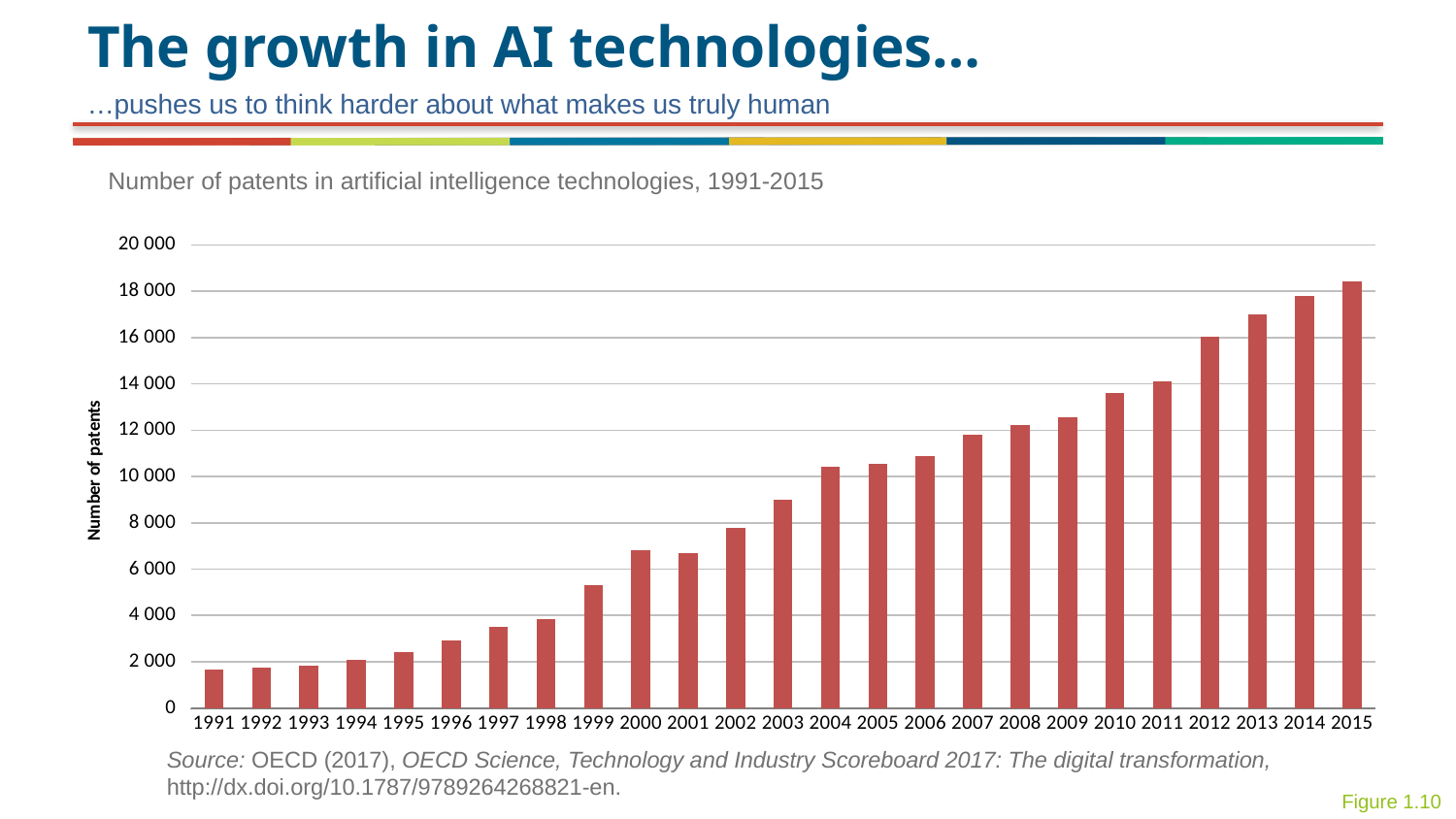
Is the value for 2003 greater or less than 10 000? less Is the value for 1999 greater or less than 4 000? greater Is the value for 1995 greater or less than 2 000? greater What kind of chart is shown on the slide? Bar chart How many years are plotted on the x axis of the chart? 25 Which year has the larger number of patents, 2013 or 2003? 2013 What is the label on the vertical axis of the chart? Number of patents Which year has the larger number of patents, 1998 or 2000? 2000 Which year has the highest number of patents in artificial intelligence technologies? 2015 Do the number of patents generally rise or fall from 1991 to 2015? Rise